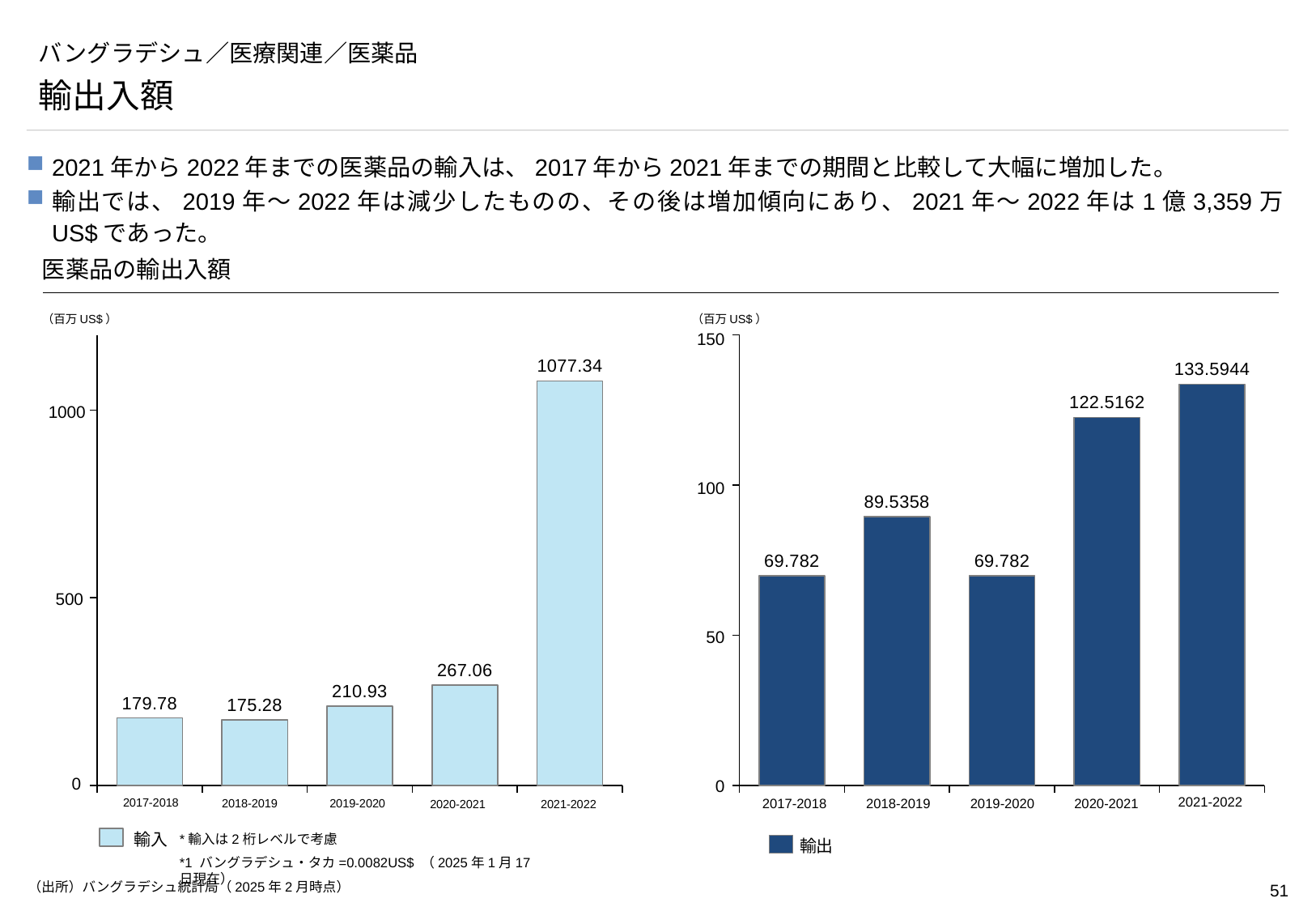
In the right chart (輸出), what is the value for 2020-2021? 122.5162 In the left chart (輸入), which period has the lowest value? 2018-2019 In the left chart (輸入), what is the value for 2019-2020? 210.93 In the right chart (輸出), what is the difference between the 2021-2022 and 2020-2021 values? 11.0782 In the left chart (輸入), what is the value for 2021-2022? 1077.34 What unit is shown above the y axis of the left chart? 百万US$ In the right chart (輸出), which period has the highest value? 2021-2022 In the right chart (輸出), what is the value for 2018-2019? 89.5358 In the left chart (輸入), what is the difference between the 2020-2021 and 2019-2020 values? 56.13 How many periods are shown on the x axis of the left chart (輸入)? 5 What type of chart is the right chart (輸出)? bar chart In the right chart (輸出), which is larger, the value for 2018-2019 or the value for 2019-2020? 2018-2019